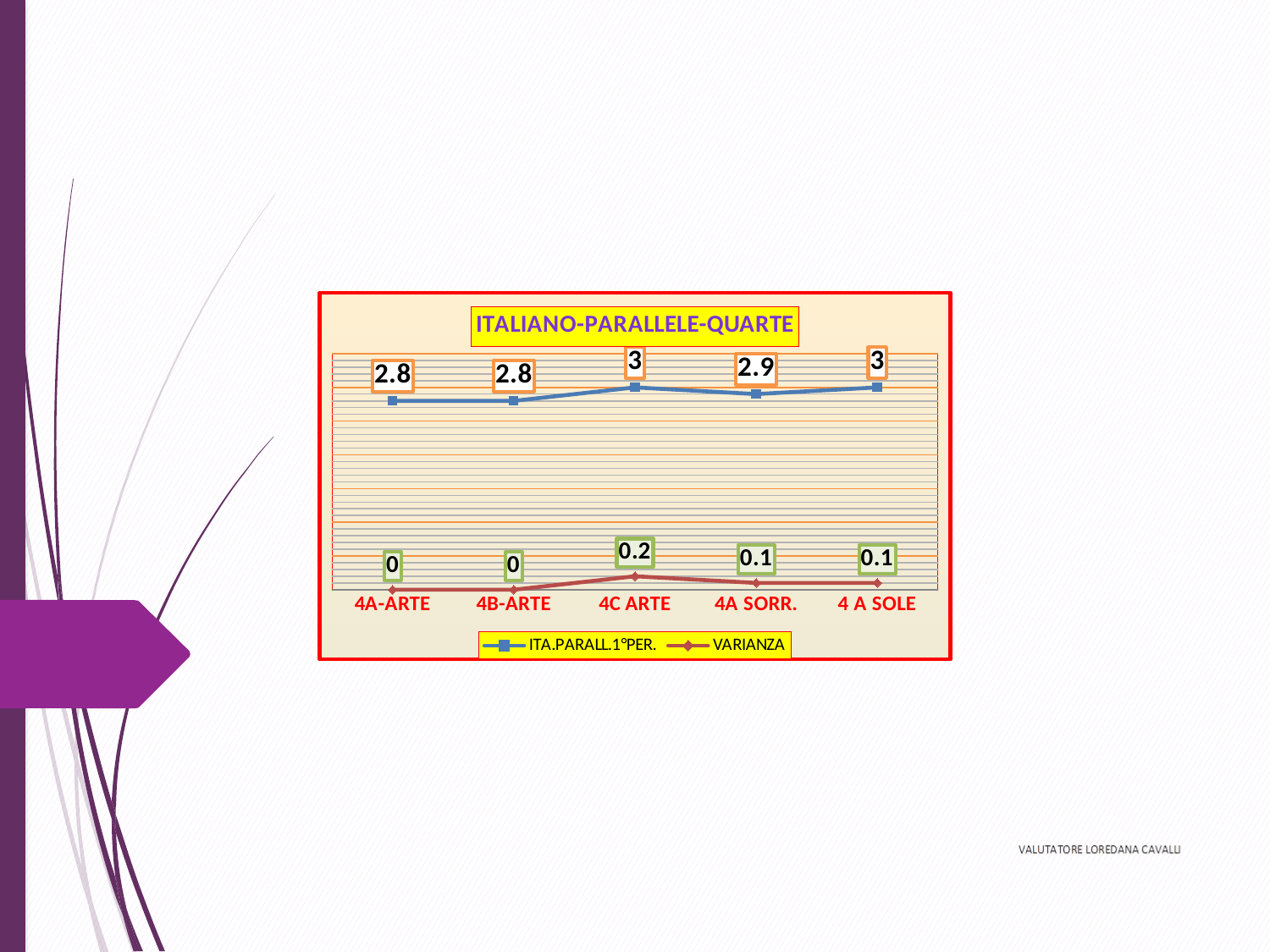
Which is larger, the ITA.PARALL.1°PER. value for 4C ARTE or for 4A SORR.? 4C ARTE What is the title of the chart? ITALIANO-PARALLELE-QUARTE Which category has the highest VARIANZA value? 4C ARTE What is the VARIANZA value for 4C ARTE? 0.2 How many categories are shown on the x axis? 5 How many series does the legend list? 2 Which series is drawn in blue according to the legend? ITA.PARALL.1°PER. What is the difference between the ITA.PARALL.1°PER. values for 4 A SOLE and 4A-ARTE? 0.2 What is the ITA.PARALL.1°PER. value for 4C ARTE? 3 What is the ITA.PARALL.1°PER. value for 4A SORR.? 2.9 What type of chart is shown on the slide? line chart What is the VARIANZA value for 4B-ARTE? 0